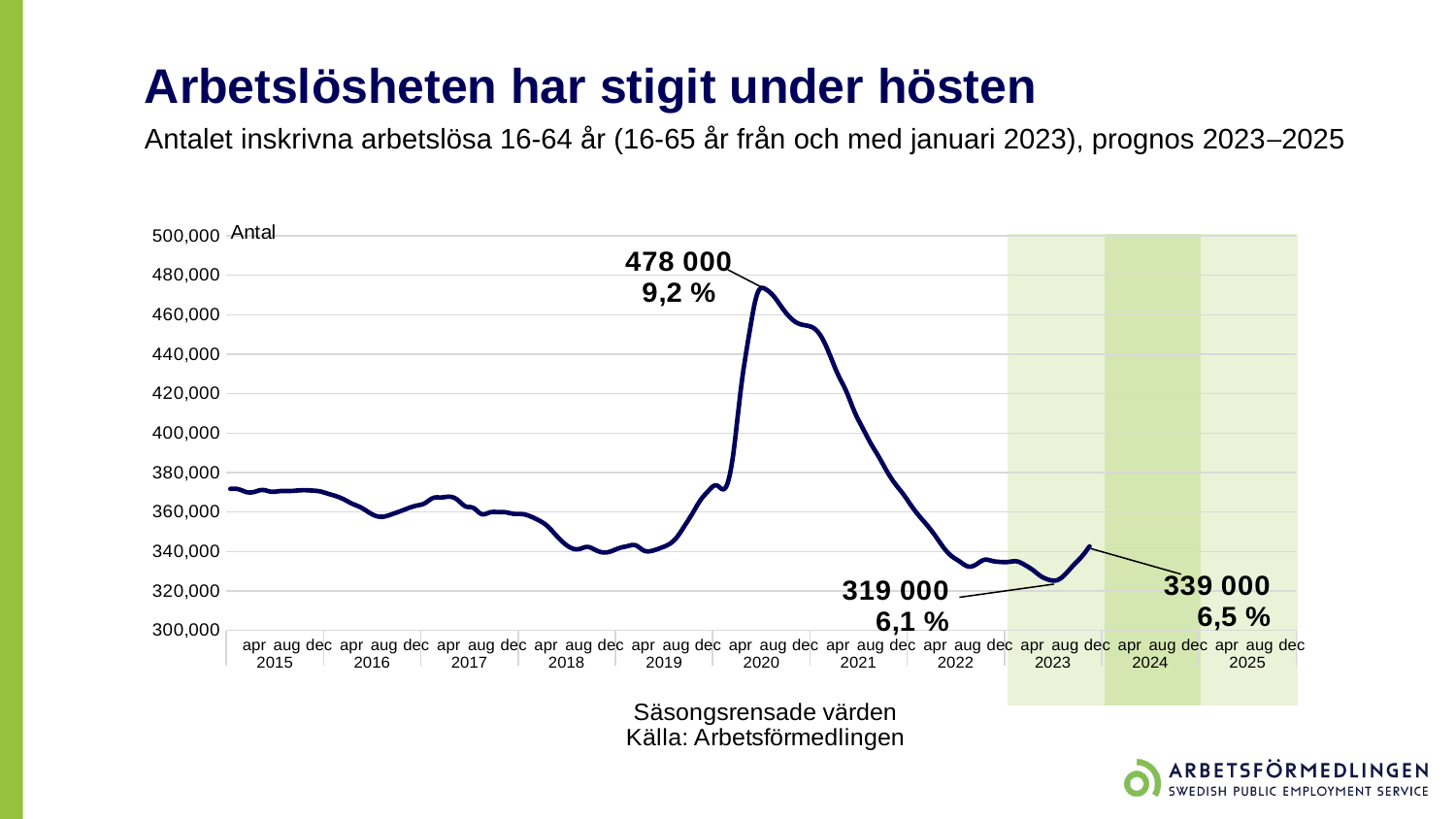
What is the labelled peak number of registered unemployed reached in 2020? 478 000 What is the labelled low value of registered unemployed in 2023? 319 000 What unemployment rate is printed next to the 339 000 forecast label? 6,5 % What unemployment rate is printed next to the 478 000 peak? 9,2 % What unemployment rate is printed next to the 319 000 label? 6,1 % What label is shown at the top of the vertical axis? Antal Is the value at the start of 2015 greater or less than 360,000? greater Does the line rise or fall between the 2020 peak and the end of 2022? fall What is the difference between the labelled 2020 peak (478 000) and the labelled 2023 low (319 000)? 159 000 By how much is the 2025 forecast value (339 000) higher than the 2023 low (319 000)? 20 000 What kind of chart is shown on the slide? line chart What is the forecast number of registered unemployed labelled at the end of 2025? 339 000